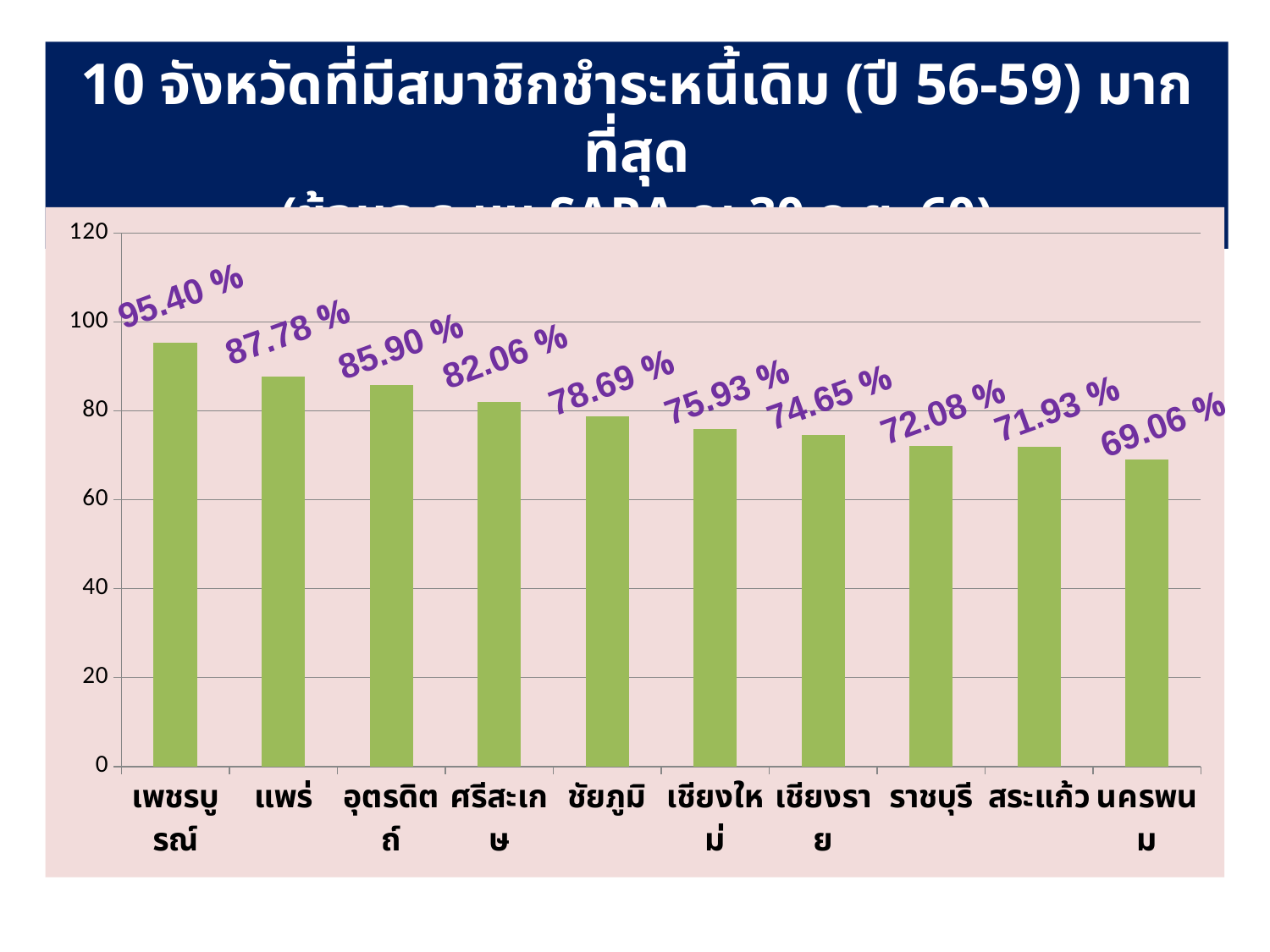
What is the difference between the values for แพร่ and อุตรดิตถ์? 1.88 % How many provinces are shown in the chart? 10 What is the value for เชียงราย? 74.65 % What is the value for นครพนม? 69.06 % Which is larger, the value for ศรีสะเกษ or the value for เชียงใหม่? ศรีสะเกษ Is the value for ราชบุรี greater or less than 80? less What is the value for เพชรบูรณ์? 95.40 % What kind of chart is shown on the slide? bar chart Which province has the highest value? เพชรบูรณ์ What is the difference between the values for เพชรบูรณ์ and นครพนม? 26.34 % Which province has the lowest value? นครพนม What is the value for ชัยภูมิ? 78.69 %